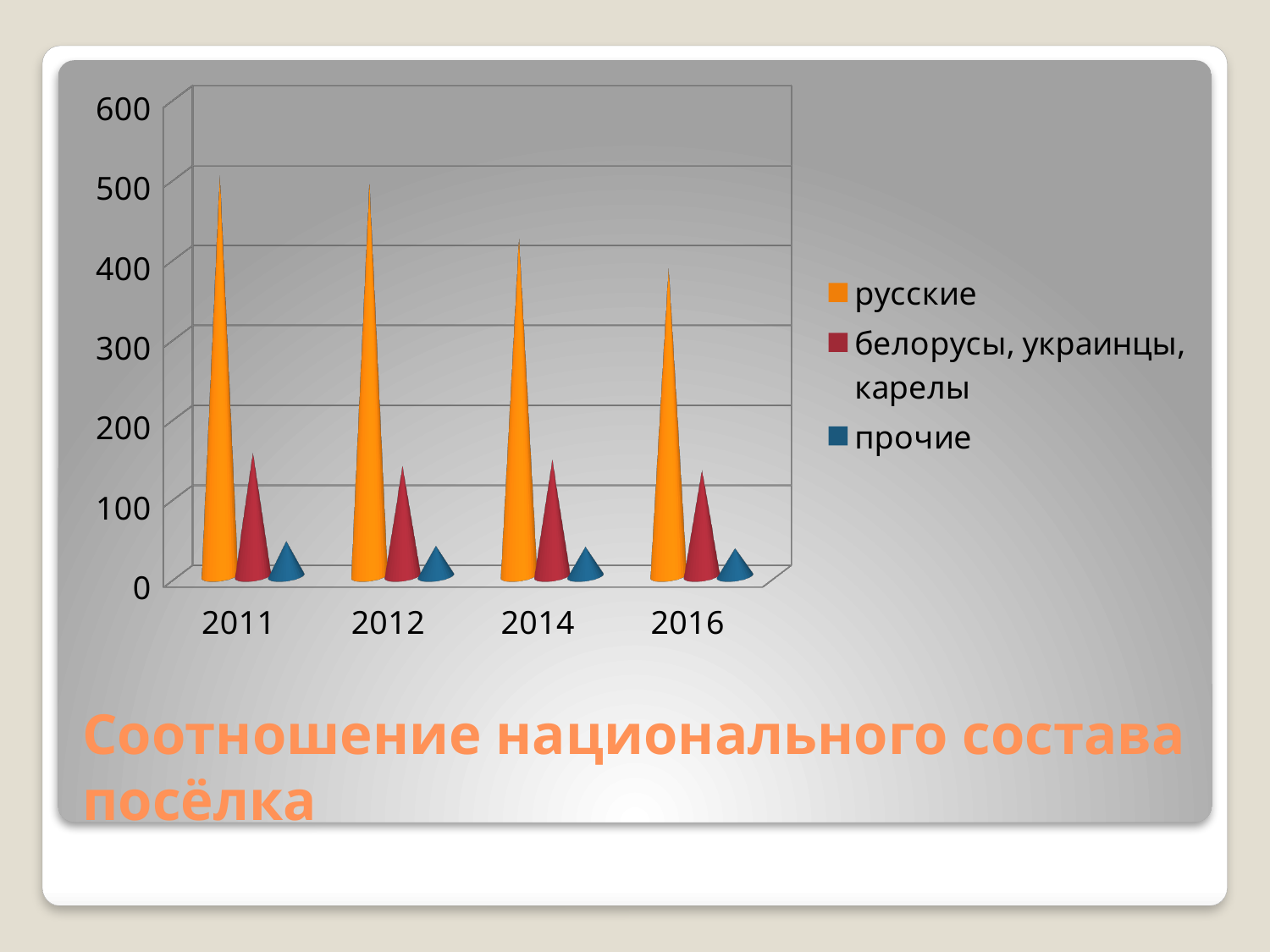
Is the value for русские in 2011 greater or less than 400? greater Is the value for русские in 2016 greater or less than 300? greater How many years are shown on the x axis of the chart? 4 In 2014, which is larger: the value for русские or the value for прочие? русские What kind of chart is shown on the slide? bar chart Do the values for русские rise or fall from 2011 to 2016? fall In which year is the value for русские lowest? 2016 Which series is shown in orange in the chart? русские Is the value for прочие in 2012 greater or less than 100? less How many series does the chart legend list? 3 What is the title of the chart on the slide? Соотношение национального состава посёлка